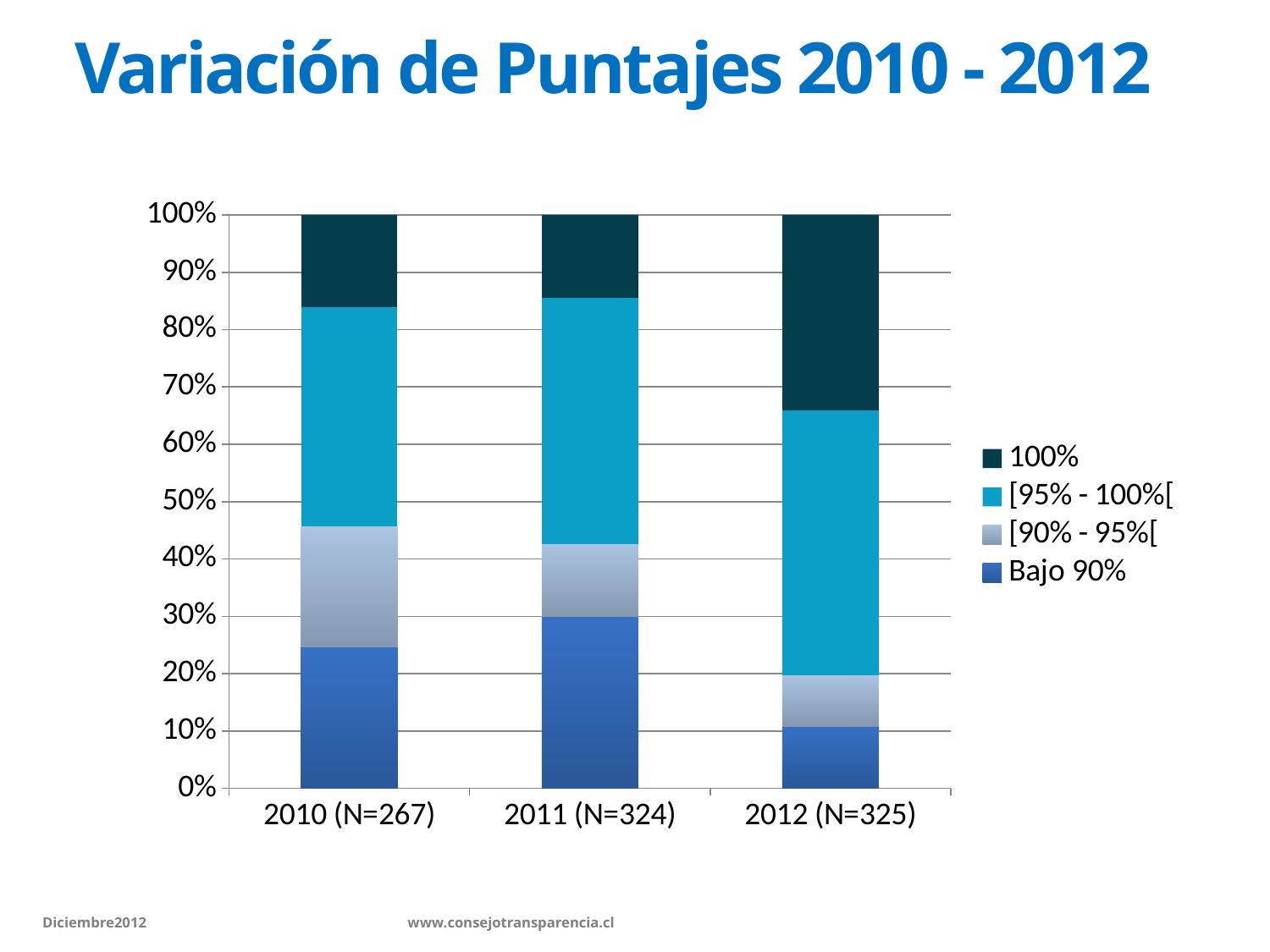
How many years (categories) are shown on the x axis? 3 What is the title of the chart on the slide? Variación de Puntajes 2010 - 2012 What kind of chart is shown on the slide? Stacked bar chart Which year has the smallest 'Bajo 90%' share? 2012 (N=325) Is the 'Bajo 90%' share for 2011 (N=324) greater or less than 20%? greater Which year has the largest 'Bajo 90%' share? 2011 (N=324) What is the N value shown in the x-axis label for 2012? 325 How many series does the legend list? 4 Which year has a larger '100%' share, 2010 (N=267) or 2012 (N=325)? 2012 (N=325) Is the '100%' share for 2012 (N=325) greater or less than 20%? greater Is the 'Bajo 90%' share for 2012 (N=325) greater or less than 20%? less Does the '[90% - 95%[' share rise or fall from 2010 to 2012? fall